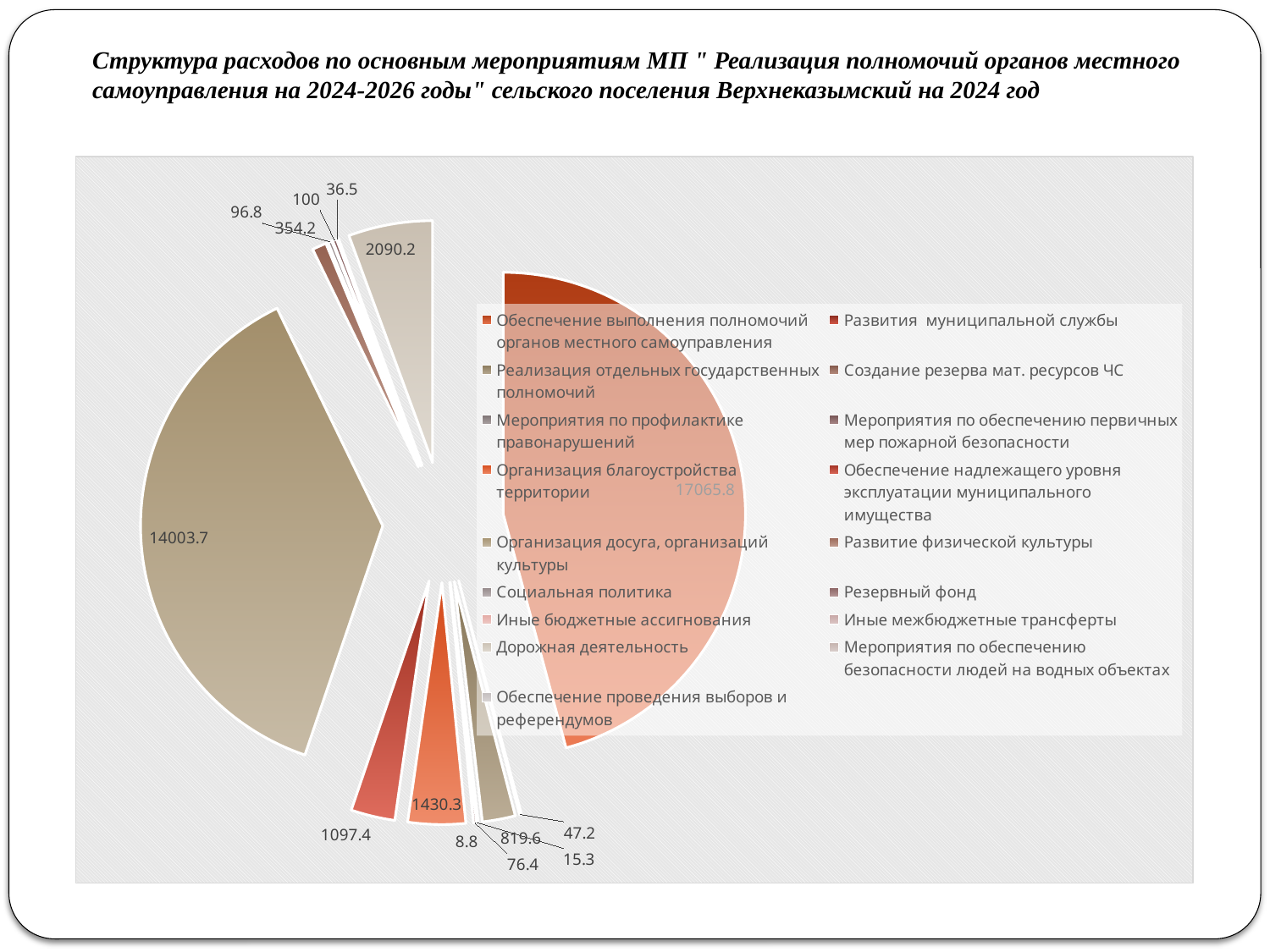
What is the value shown for "Реализация отдельных государственных полномочий"? 819.6 What is the value shown for "Обеспечение выполнения полномочий органов местного самоуправления"? 17065.8 What is the difference between the two largest labelled slices, 17065.8 and 14003.7? 3062.1 Which year does the chart title say the expenditure structure is for? 2024 Which settlement is named in the chart title? сельское поселение Верхнеказымский Which is larger: the value for "Обеспечение выполнения полномочий органов местного самоуправления" or the value for "Реализация отдельных государственных полномочий"? Обеспечение выполнения полномочий органов местного самоуправления What kind of chart is shown on the slide? pie chart How many categories does the legend of the pie chart list? 17 What is the second-largest value labelled on the pie chart? 14003.7 What is the largest value labelled on the pie chart? 17065.8 What is the smallest value labelled on the pie chart? 8.8 Is the value for "Реализация отдельных государственных полномочий" greater or less than 10000? less